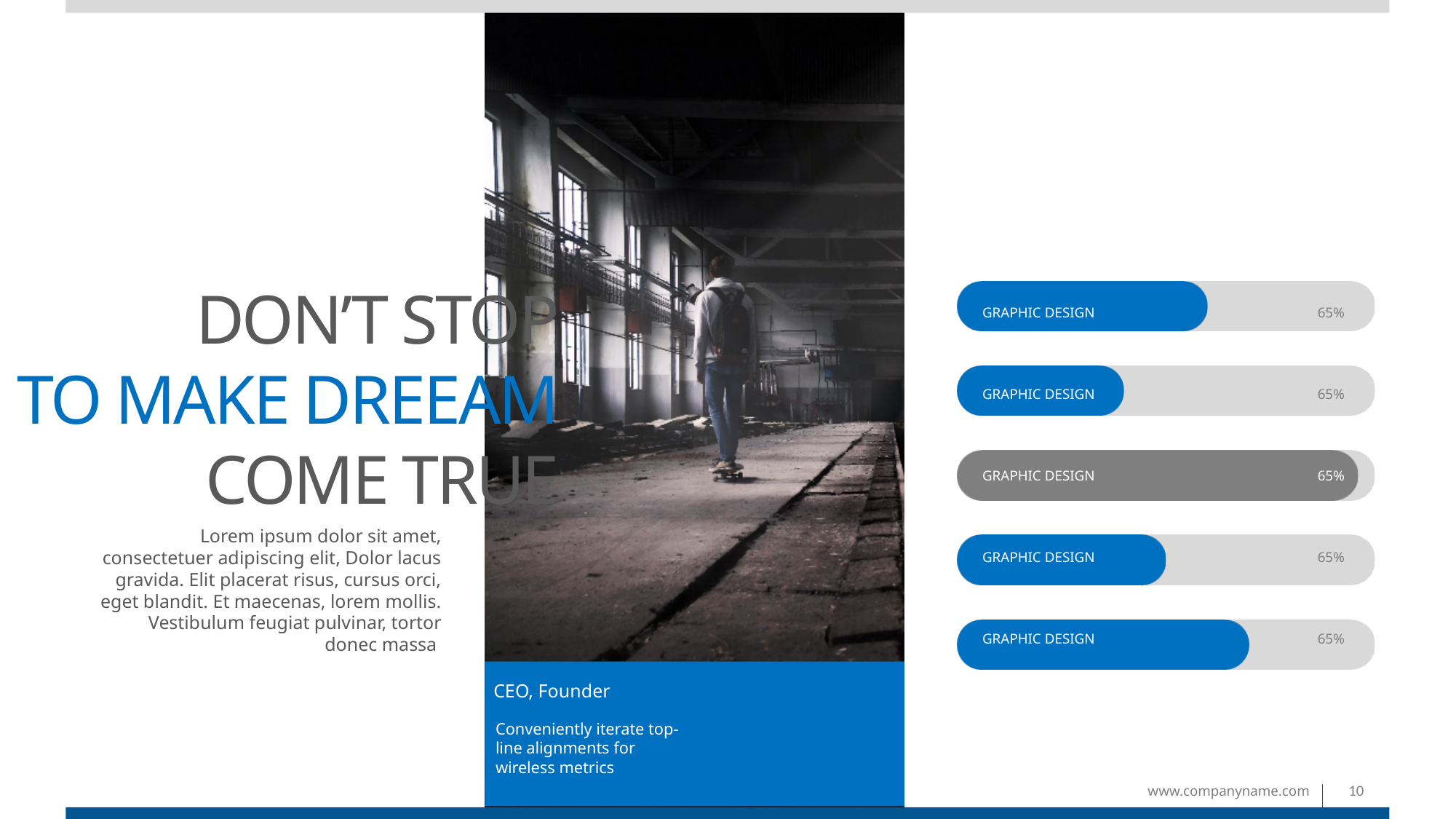
Which bar in the chart is coloured grey rather than blue? the third bar What value is printed on the first (top) bar of the chart? 65% How many bars are shown in the chart on the right side of the slide? 5 What value is printed on the third bar of the chart? 65% What kind of chart is shown on the right side of the slide? bar chart Are the bars in the chart oriented horizontally or vertically? horizontally What label appears on each bar of the chart? GRAPHIC DESIGN What value is printed on the bottom bar of the chart? 65%